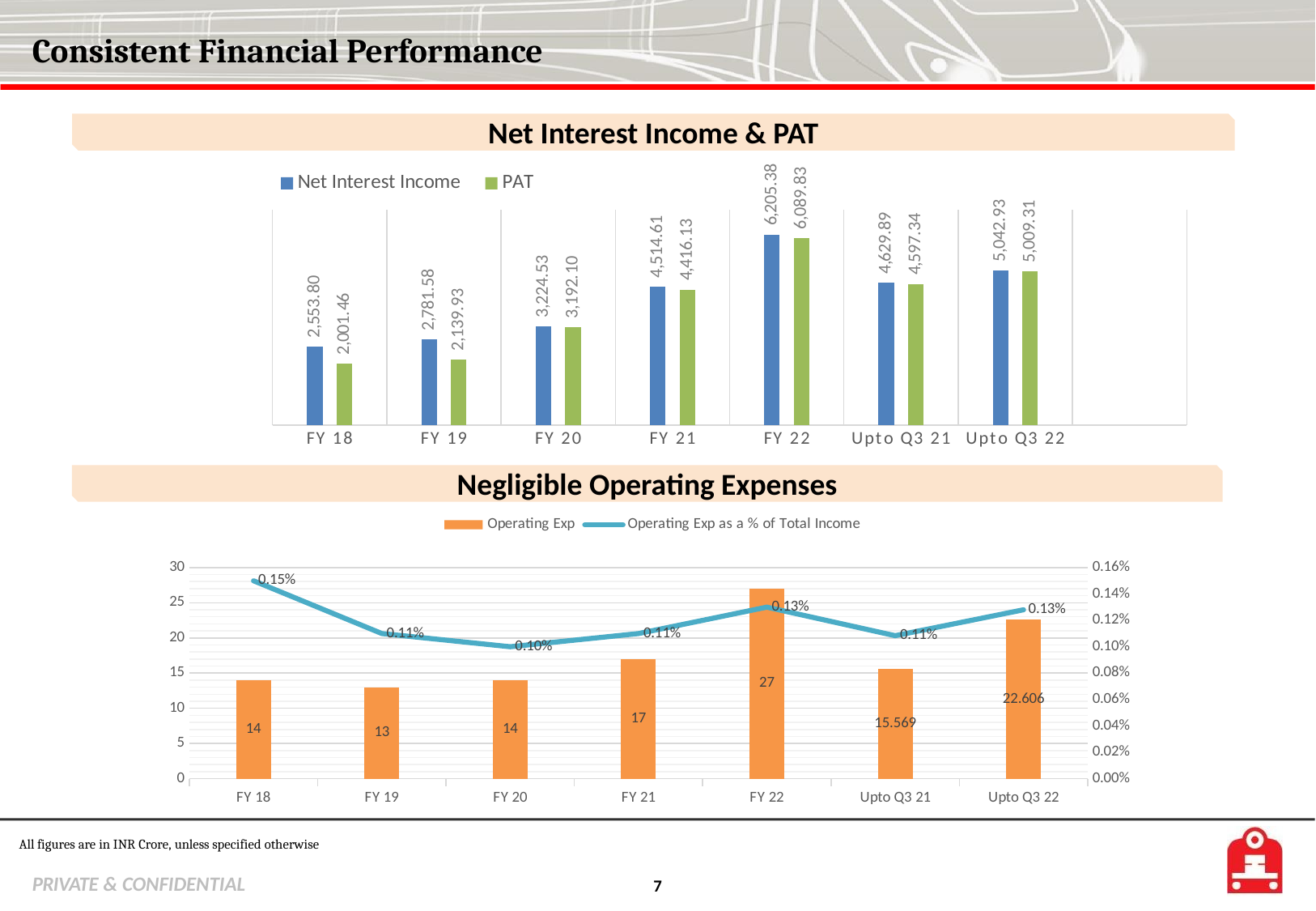
In the Net Interest Income & PAT chart, how many series does the legend list? 2 In the Negligible Operating Expenses chart, what is Operating Exp as a % of Total Income for FY 18? 0.15% In the Negligible Operating Expenses chart, is the Operating Exp for FY 22 larger or smaller than for FY 21? larger What kind of chart is the Net Interest Income & PAT chart? bar chart In the Net Interest Income & PAT chart, what is the Net Interest Income for FY 22? 6,205.38 In the Negligible Operating Expenses chart, which period has the lowest Operating Exp? FY 19 In the Negligible Operating Expenses chart, which period has the lowest Operating Exp as a % of Total Income? FY 20 In the Net Interest Income & PAT chart, how many periods are shown on the x axis? 7 In the Net Interest Income & PAT chart, what is the difference between Net Interest Income and PAT for FY 20? 32.43 In the Net Interest Income & PAT chart, which period has the highest PAT? FY 22 In the Negligible Operating Expenses chart, what is the Operating Exp for Upto Q3 22? 22.606 In the Net Interest Income & PAT chart, what is the PAT for FY 18? 2,001.46